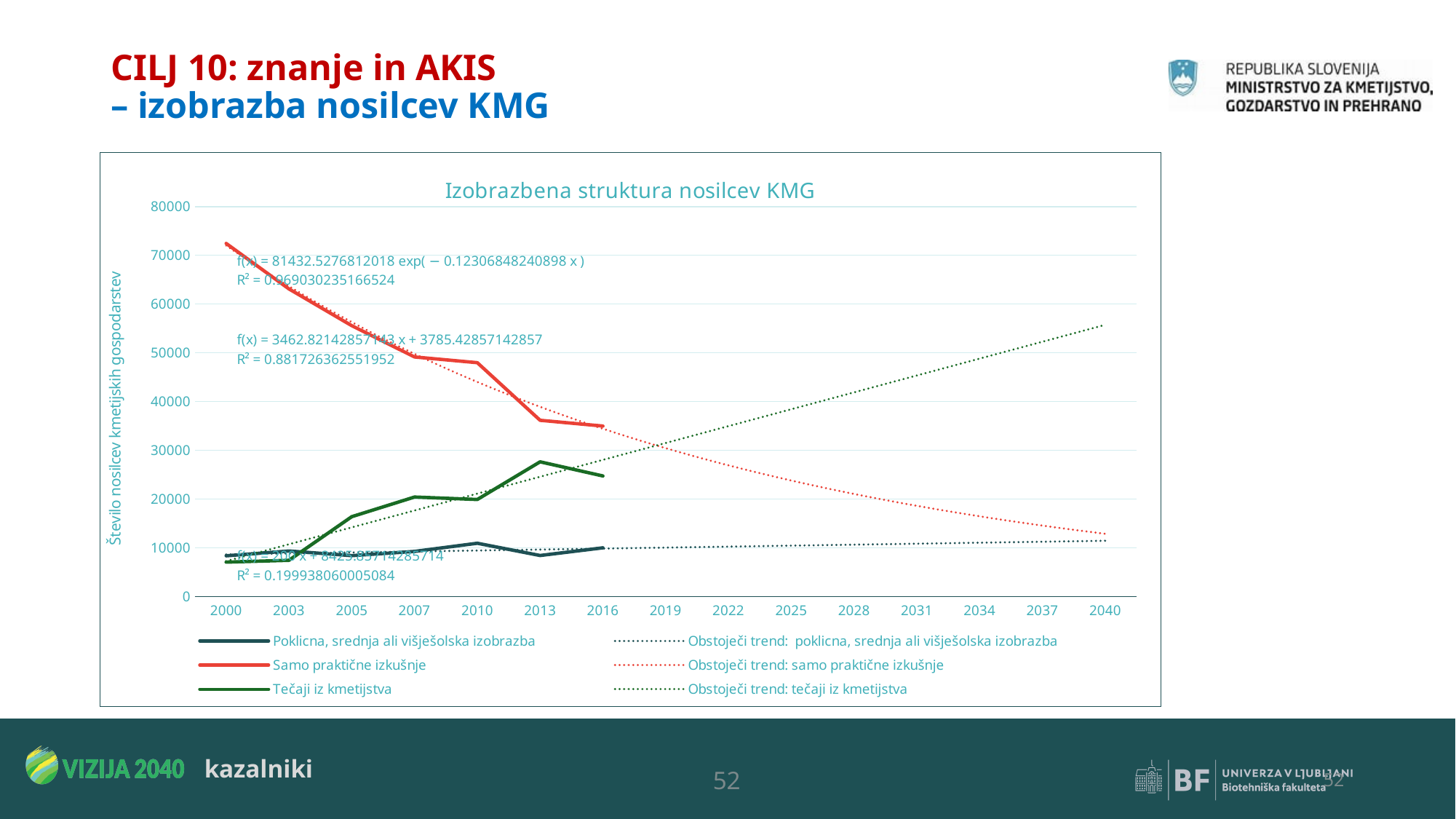
Does the 'Samo praktične izkušnje' series rise or fall from 2000 to 2016? fall Is the value for 'Samo praktične izkušnje' in 2000 greater or less than 70000? greater In 2016, which is larger: 'Samo praktične izkušnje' or 'Tečaji iz kmetijstva'? Samo praktične izkušnje Is the value for 'Samo praktične izkušnje' in 2016 greater or less than 40000? less What type of chart is shown on the slide? line chart What is the label of the vertical axis? Število nosilcev kmetijskih gospodarstev Which series has the highest value in 2000? Samo praktične izkušnje Does the 'Tečaji iz kmetijstva' series rise or fall from 2000 to 2013? rise Is the value for 'Tečaji iz kmetijstva' in 2013 greater or less than 20000? greater How many series does the chart legend list? 6 What is the title of the chart? Izobrazbena struktura nosilcev KMG